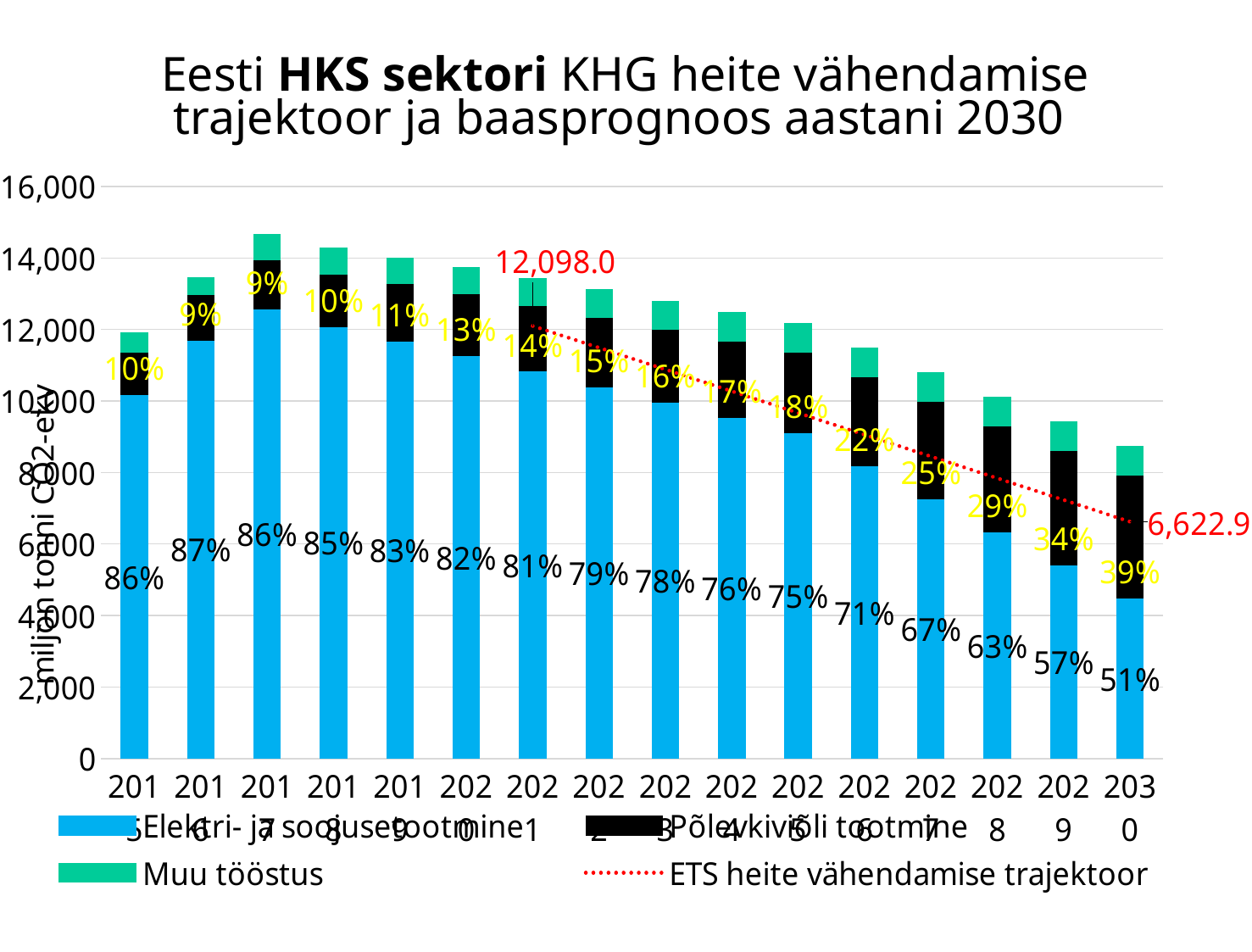
What value is labelled on the ETS heite vähendamise trajektoor line at 2030? 6,622.9 How many entries does the legend list? 4 What kind of chart is shown on the slide? combination bar and line chart (stacked bars with a dotted line) What percentage label is shown for Põlevkiviõli tootmine in 2030? 39% What value is labelled on the ETS heite vähendamise trajektoor line at 2021? 12,098.0 Which year has the tallest stacked bar? 2017 Which year has the shortest stacked bar? 2030 How many years are shown along the x axis? 16 What percentage label is shown for Elektri- ja soojuse tootmine in 2030? 51% Is the total stacked bar for 2030 greater or less than 10,000? less Do the stacked bar totals rise or fall from 2017 to 2030? fall What is the difference between the two labelled values on the ETS heite vähendamise trajektoor line (12,098.0 and 6,622.9)? 5,475.1